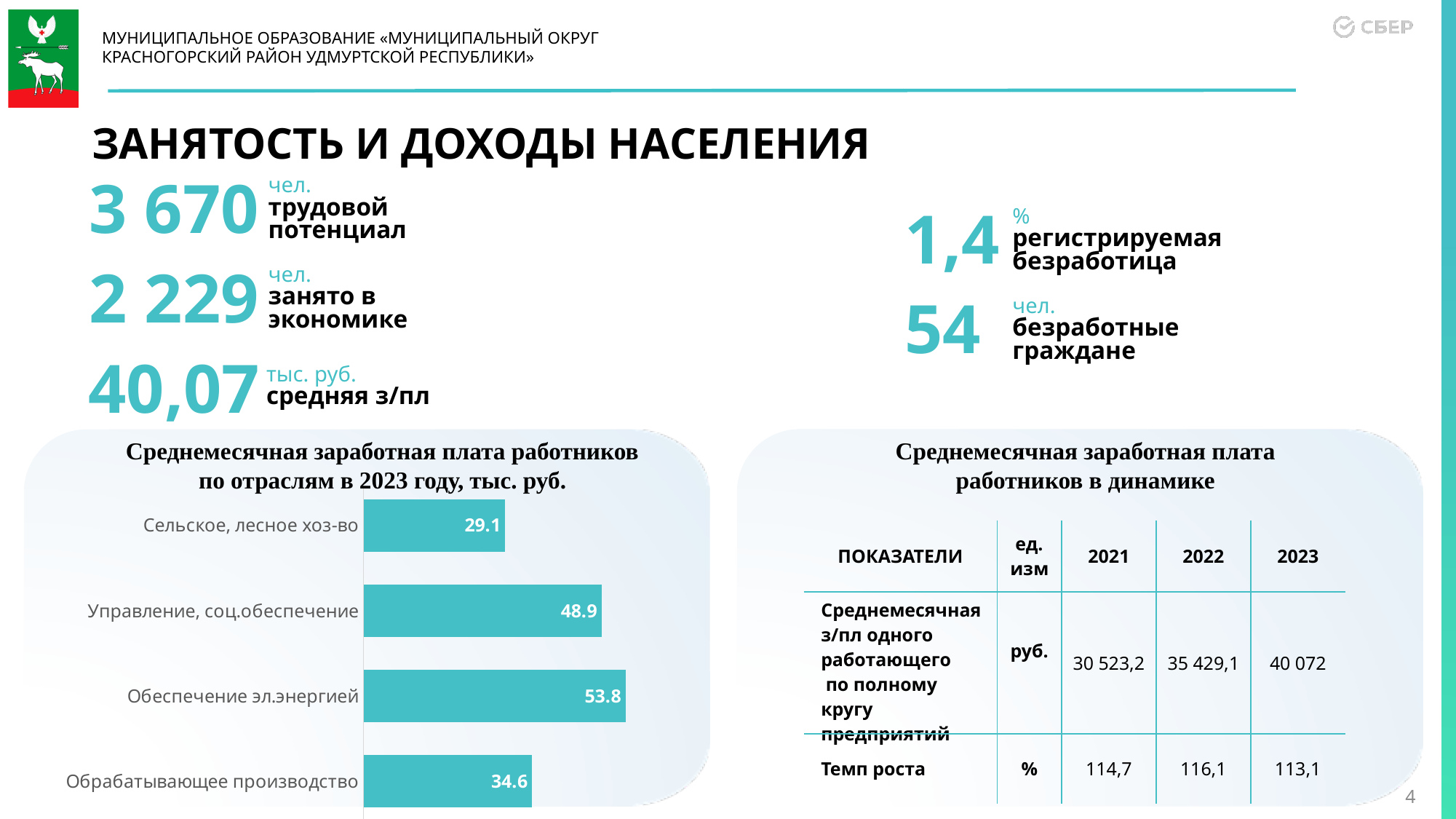
How many categories are shown in the bar chart? 4 What is the value for Обрабатывающее производство in the bar chart? 34.6 Which is larger in the bar chart: the value for Управление, соц.обеспечение or the value for Обрабатывающее производство? Управление, соц.обеспечение What kind of chart is shown on the left of the slide? Bar chart What is the title of the bar chart? Среднемесячная заработная плата работников по отраслям в 2023 году, тыс. руб. What is the value for Управление, соц.обеспечение in the bar chart? 48.9 Which category has the lowest value in the bar chart? Сельское, лесное хоз-во What is the value for Сельское, лесное хоз-во in the bar chart? 29.1 What is the difference between the values for Управление, соц.обеспечение and Обрабатывающее производство in the bar chart? 14.3 What is the difference between the values for Обеспечение эл.энергией and Сельское, лесное хоз-во in the bar chart? 24.7 Which category has the highest value in the bar chart? Обеспечение эл.энергией What is the value for Обеспечение эл.энергией in the bar chart? 53.8